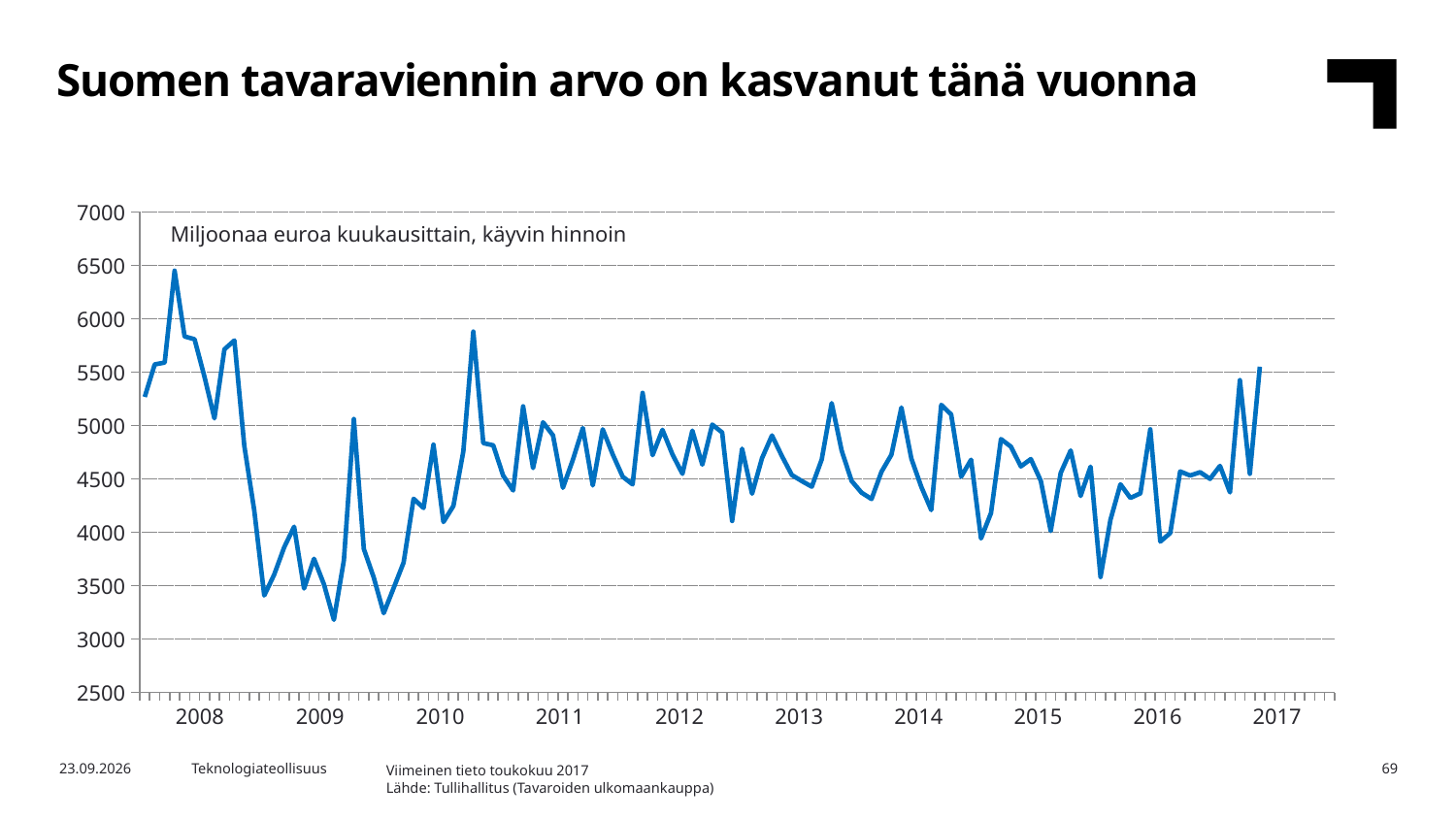
Is the lowest value in 2015 greater or less than 4000? less How many year labels are shown on the x axis? 10 In which year does the line reach its highest value? 2008 What unit description is printed inside the chart area? Miljoonaa euroa kuukausittain, käyvin hinnoin Is the peak value in 2010 greater or less than 5500? greater What is the title of the slide? Suomen tavaraviennin arvo on kasvanut tänä vuonna Is the lowest value in 2009 greater or less than 3500? less In which year does the line reach its lowest value? 2009 Does the line rise or fall from its 2008 peak to the end of 2008? fall What kind of chart is shown on the slide? line chart